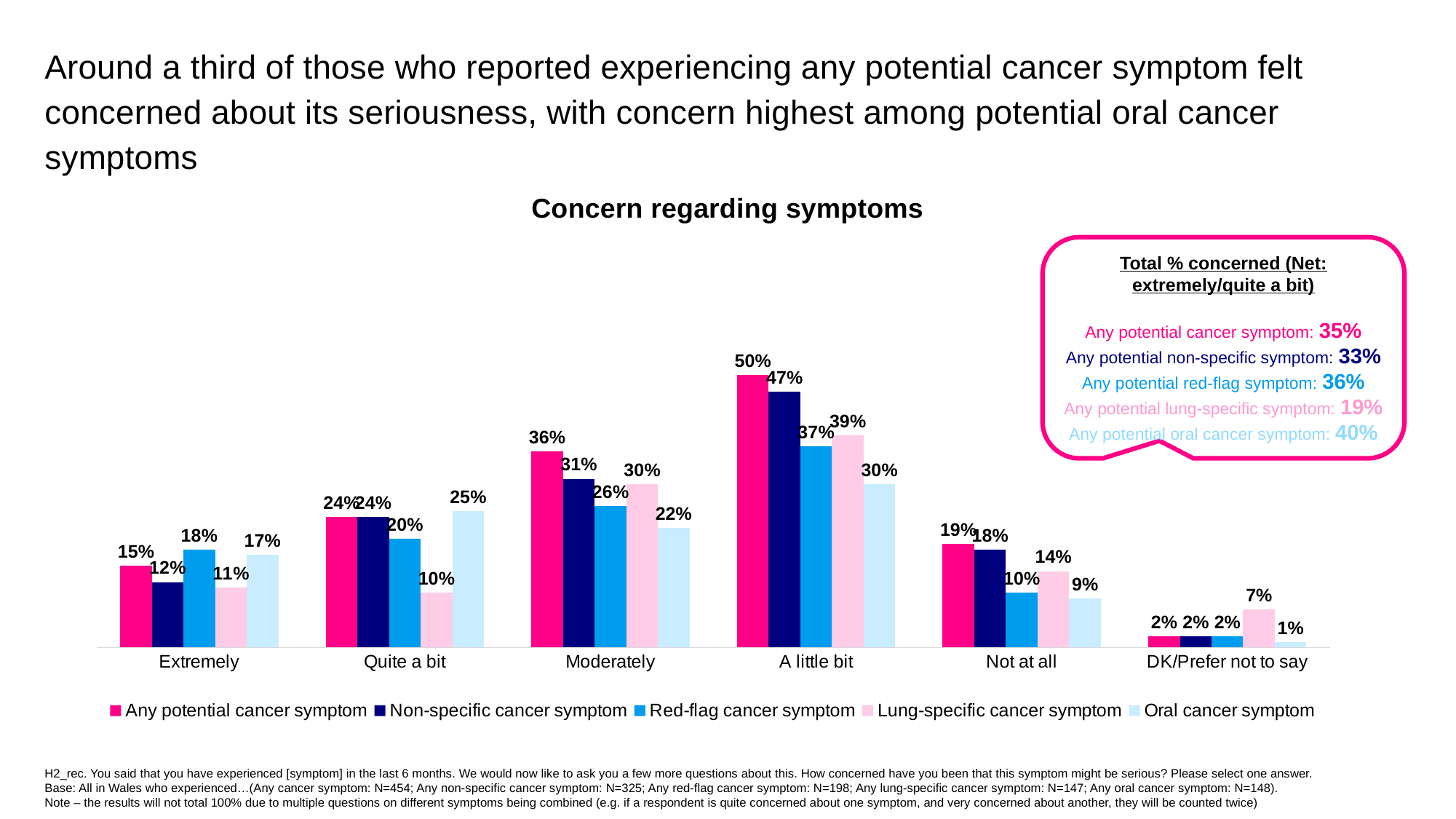
What type of chart is shown on the slide? bar chart What is the value for Lung-specific cancer symptom in the 'DK/Prefer not to say' category? 7% What is the value for Oral cancer symptom in the 'Quite a bit' category? 25% Which is larger in the 'Extremely' category: Red-flag cancer symptom or Lung-specific cancer symptom? Red-flag cancer symptom What is the value for Any potential cancer symptom in the 'A little bit' category? 50% Which series has the highest value in the 'Moderately' category? Any potential cancer symptom How many categories are shown on the x axis? 6 What is the difference between the Any potential cancer symptom and Non-specific cancer symptom values in the 'A little bit' category? 3% What is the title of the chart? Concern regarding symptoms Which series has the lowest value in the 'Not at all' category? Oral cancer symptom How many series does the legend list? 5 What is the value for Red-flag cancer symptom in the 'Moderately' category? 26%